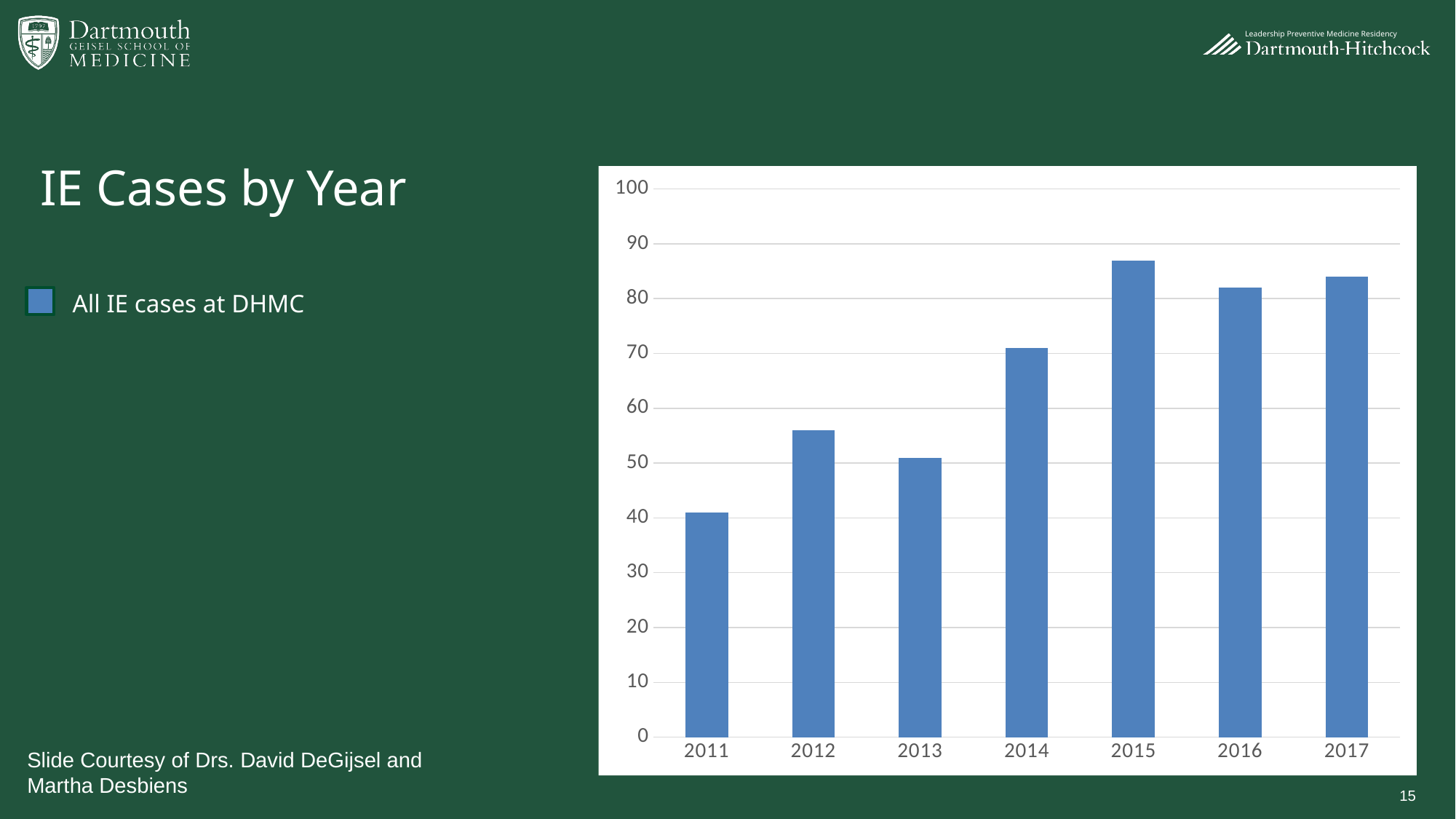
How many series does the legend list? 1 What kind of chart is shown on the slide? bar chart Which year has more IE cases, 2012 or 2013? 2012 Is the value for 2016 greater or less than 90? less Which year has the lowest number of IE cases? 2011 What is the title of the slide's chart? IE Cases by Year Overall, do the IE case counts rise or fall from 2011 to 2017? rise How many years are shown on the x axis of the chart? 7 Which year has the highest number of IE cases? 2015 What is the legend entry for the series plotted in the chart? All IE cases at DHMC Is the value for 2011 greater or less than 50? less